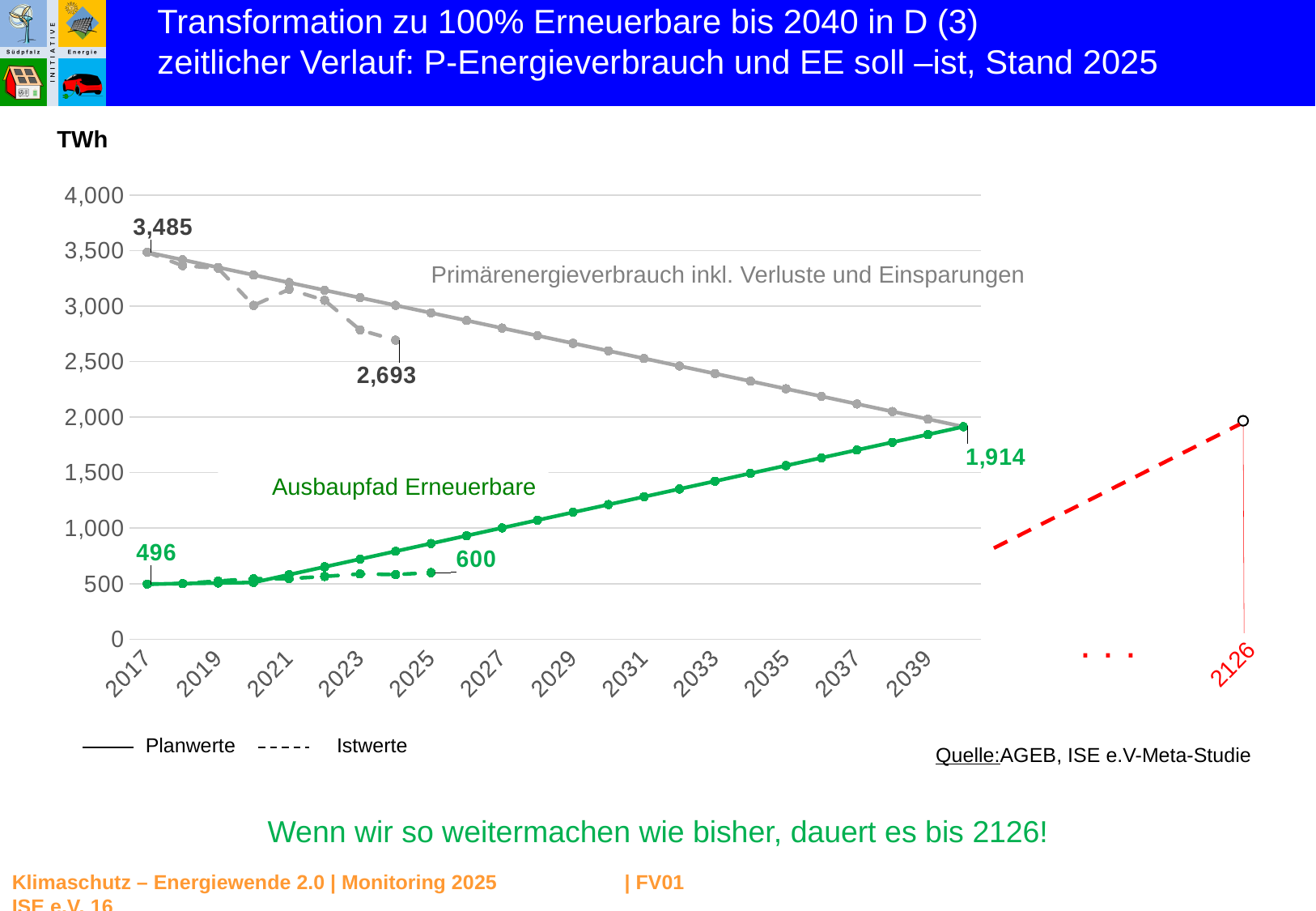
In the legend, which line style represents Istwerte? dashed What value is labelled where the Primärenergieverbrauch line and the Ausbaupfad Erneuerbare line meet in 2040? 1,914 What is the difference between the 2017 Primärenergieverbrauch (3,485) and the 2017 Erneuerbare value (496)? 2,989 What is the labelled Istwert at the end of the dashed Primärenergieverbrauch line? 2,693 Does the Planwerte line for Primärenergieverbrauch rise or fall from 2017 to 2040? fall Is the Planwert for Primärenergieverbrauch in 2035 greater or less than 2,500? less What is the value of the Ausbaupfad Erneuerbare in 2017? 496 How much higher is the 2025 Istwert for Erneuerbare (600) than the 2017 value (496)? 104 What is the value of Primärenergieverbrauch in 2017? 3,485 By how much does the labelled Istwert 2,693 fall below the 2017 Primärenergieverbrauch of 3,485? 792 What is the labelled Istwert for Erneuerbare in 2025? 600 What kind of chart is shown on the slide? line chart